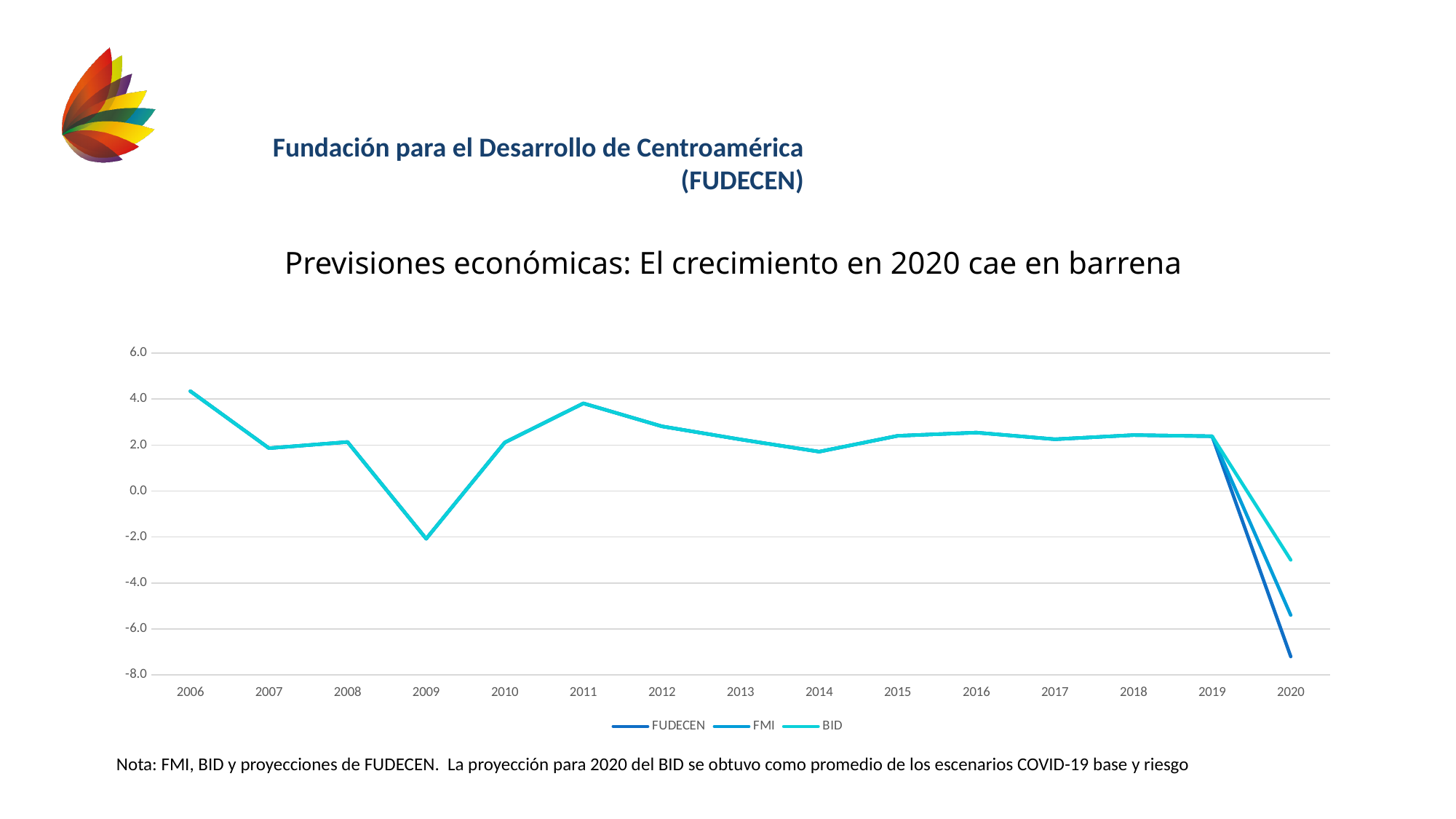
How many years are shown on the x axis? 15 Which series are listed in the legend? FUDECEN, FMI, BID What is the title of the chart? Previsiones económicas: El crecimiento en 2020 cae en barrena Is the value for 2009 greater or less than 0.0? less What kind of chart is shown on the slide? line chart Is the BID value for 2020 greater or less than -4.0? greater In which year do the lines reach their lowest value? 2020 For 2020, which series has the lower value, FUDECEN or BID? FUDECEN In which year is the value highest? 2006 Is the FUDECEN value for 2020 greater or less than -6.0? less Do the lines rise or fall from 2019 to 2020? fall How many series does the legend list? 3